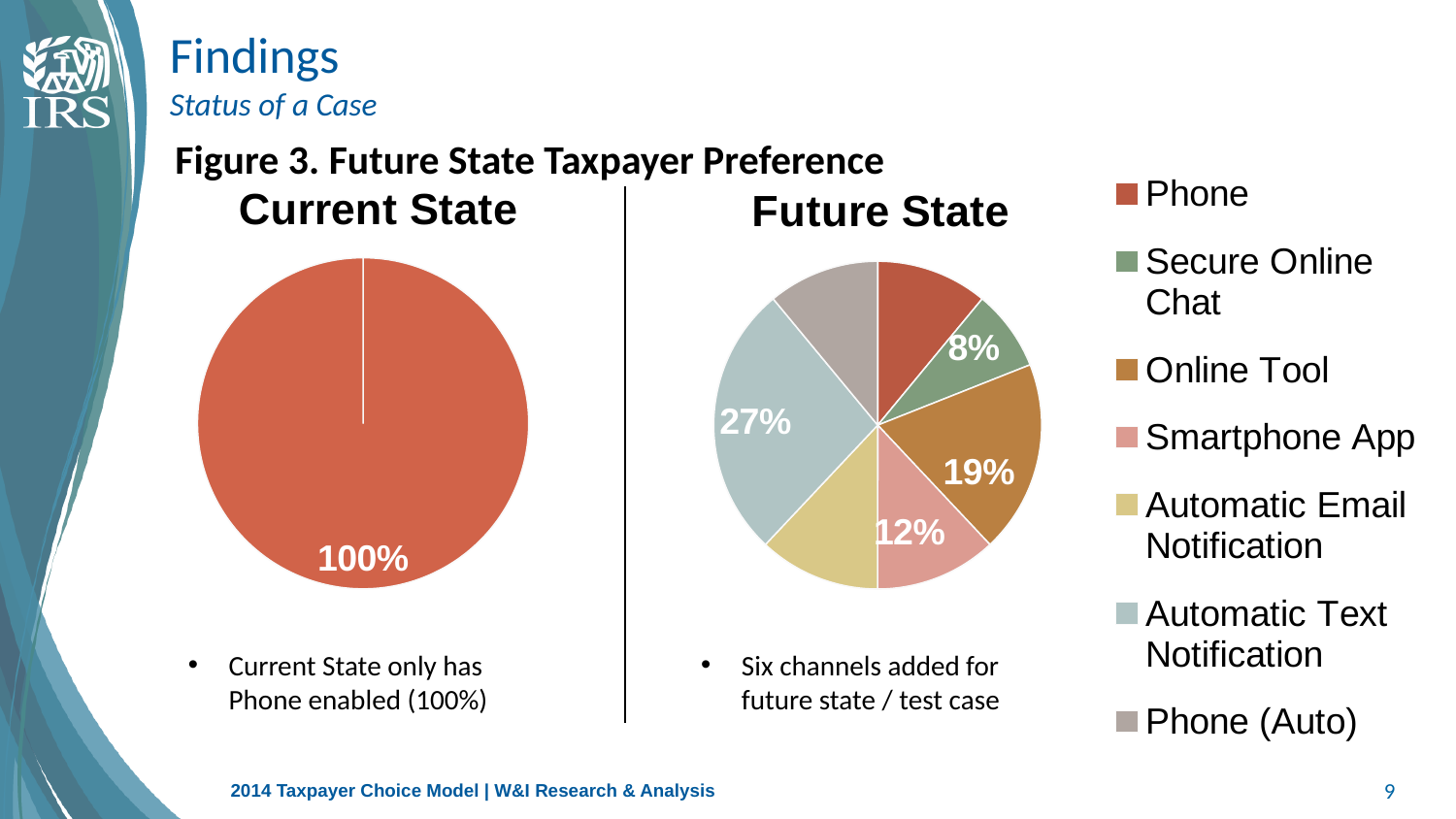
In the Future State pie chart, which is larger: Online Tool or Smartphone App? Online Tool In the Future State pie chart, what share does Smartphone App have? 12% In the Future State pie chart, what share does Online Tool have? 19% How many channels does the legend list? 7 How many slices does the Future State pie chart have? 7 In the Current State pie chart, what share does Phone have? 100% In the Future State pie chart, which channel has the largest share? Automatic Text Notification In the Future State pie chart, what share does Automatic Text Notification have? 27% What is the title of the figure containing the two pie charts? Figure 3. Future State Taxpayer Preference In the Future State pie chart, what is the difference between the Automatic Text Notification share and the Online Tool share? 8 percentage points In the Future State pie chart, what share does Secure Online Chat have? 8% What kind of chart is used for the Current State and Future State figures? Pie chart